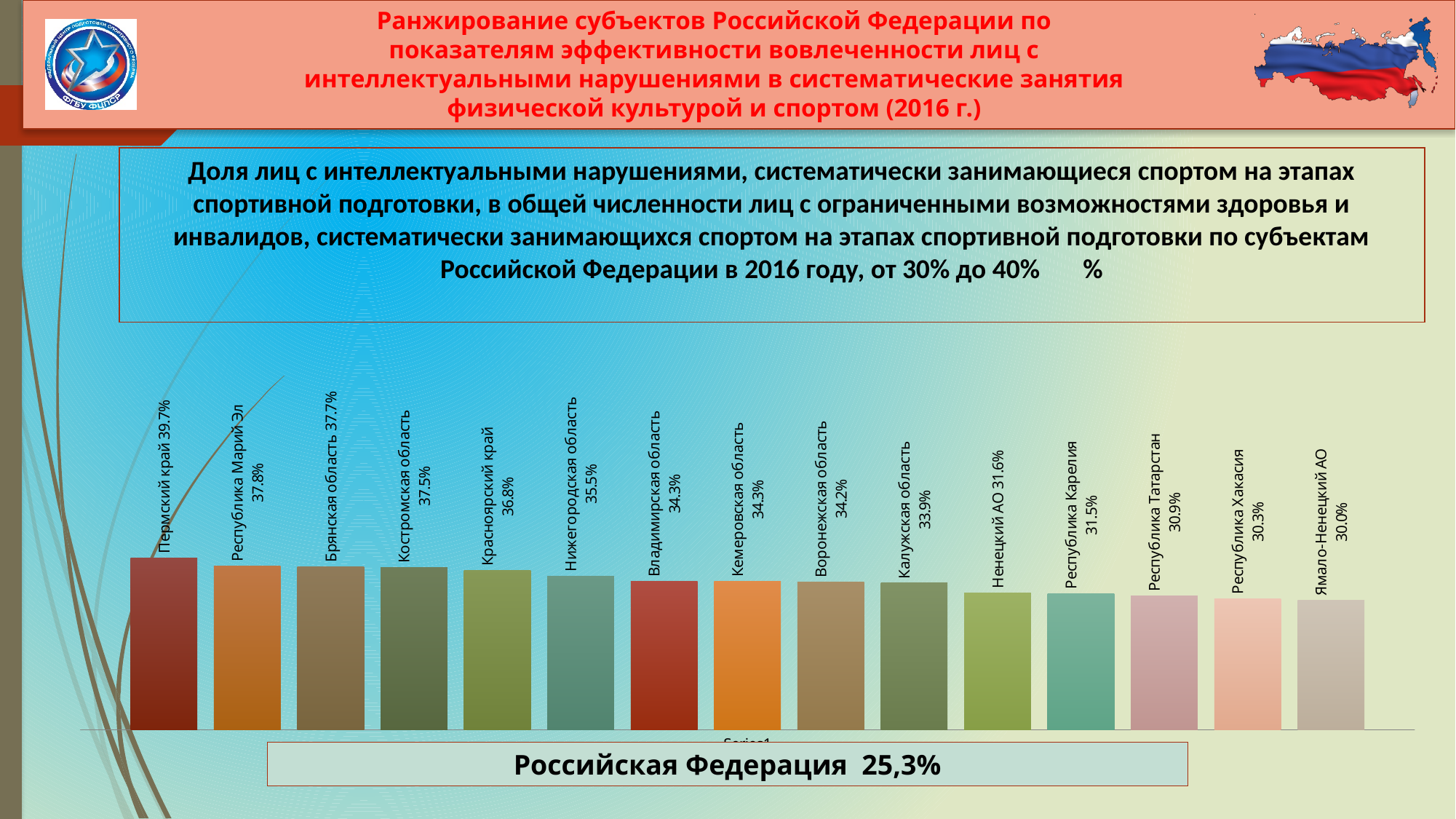
Which region has the lowest value in the chart? Ямало-Ненецкий АО What is the value shown for Красноярский край? 36.8% Which region has the highest value in the chart? Пермский край What is the value shown for Республика Татарстан? 30.9% What kind of chart is shown on the slide? bar chart What is the difference between the values for Пермский край and Ямало-Ненецкий АО? 9.7% How many regions (bars) are plotted in the chart? 15 Which has the larger value, Нижегородская область or Воронежская область? Нижегородская область What value is given for the Российская Федерация in the box below the chart? 25,3% What is the value shown for Пермский край? 39.7% What is the value shown for Калужская область? 33.9% Do the values rise or fall from left to right across the chart? fall